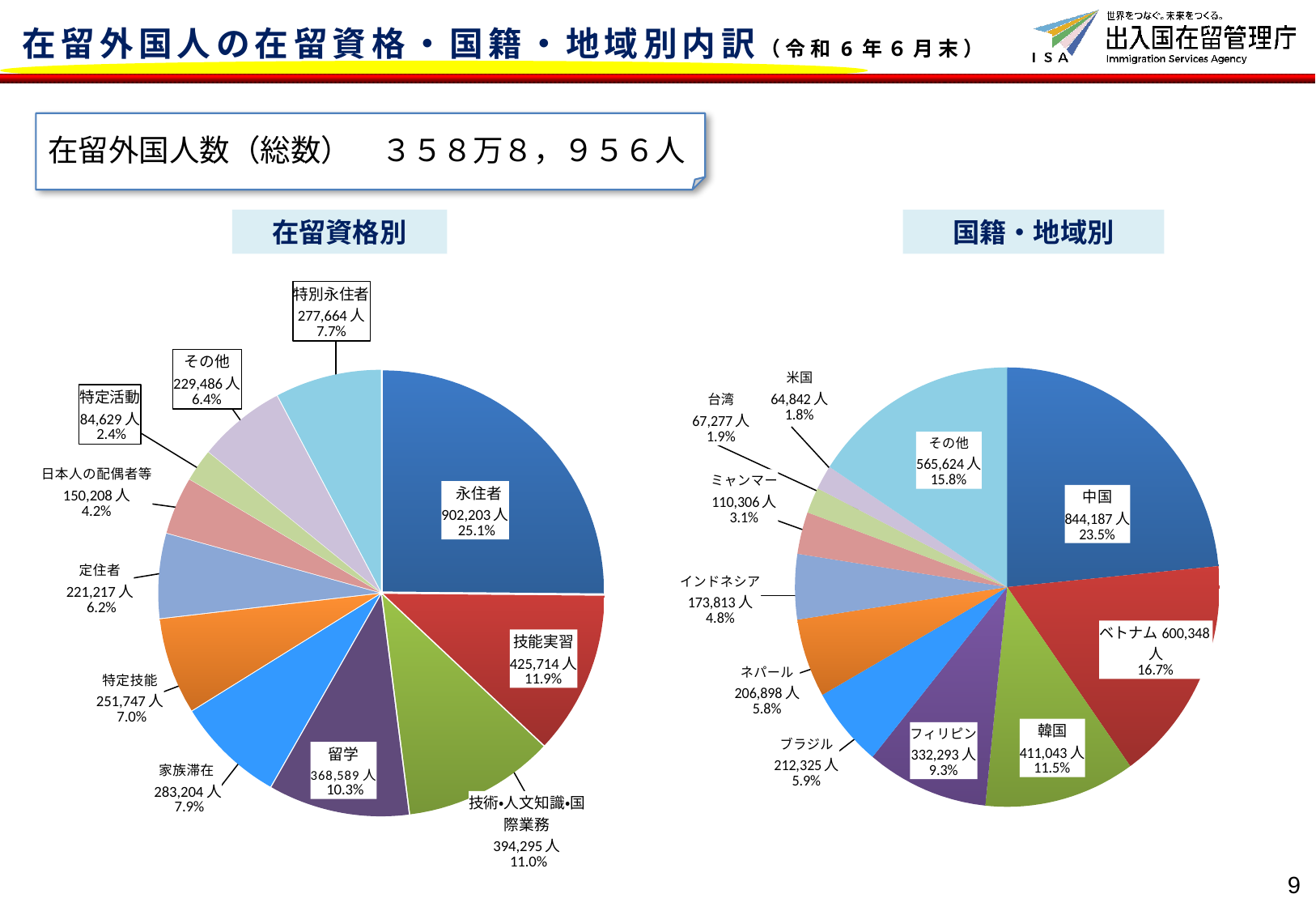
In the 在留資格別 pie chart, what is the number of people for 永住者? 902,203 人 How many categories are shown in the 在留資格別 pie chart? 11 In the 在留資格別 pie chart, which is larger, 家族滞在 or 特定技能? 家族滞在 In the 国籍・地域別 pie chart, what share of the total does 韓国 represent? 11.5% In the 国籍・地域別 pie chart, what is the difference in people between ブラジル and ネパール? 5,427 人 What type of chart is used for the 国籍・地域別 breakdown? Pie chart In the 国籍・地域別 pie chart, what is the number of people for ベトナム? 600,348 人 In the 国籍・地域別 pie chart, which nationality/region has the largest value? 中国 In the 在留資格別 pie chart, which category has the smallest value? 特定活動 In the 在留資格別 pie chart, what share of the total does 留学 represent? 10.3% In the 在留資格別 pie chart, what is the difference in people between 技能実習 and 技術・人文知識・国際業務? 31,419 人 What total number of foreign residents is stated on the slide? 358万8,956人